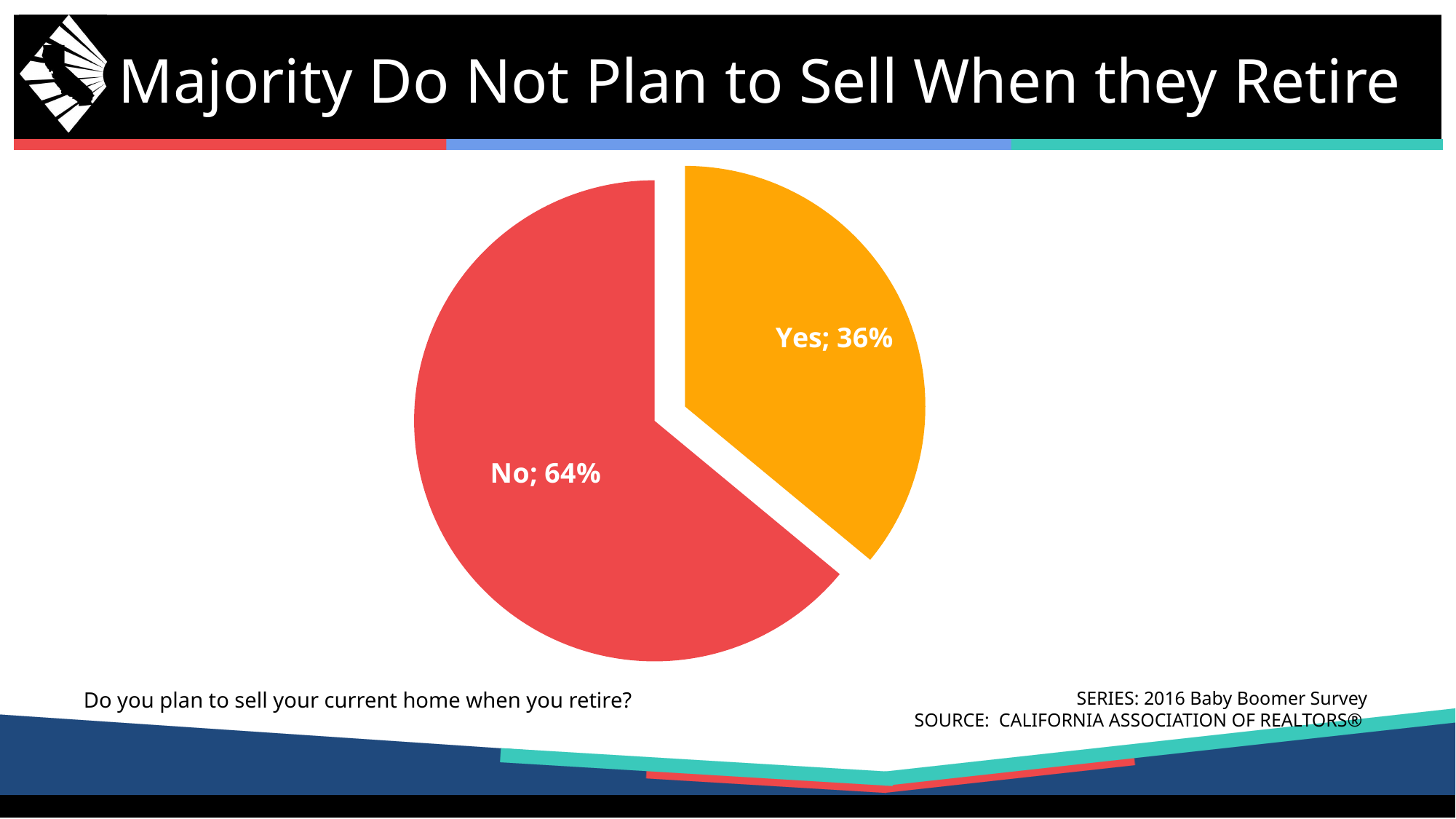
How many slices does the pie chart have? 2 What kind of chart is shown on the slide? Pie chart Which is larger, the "Yes" slice or the "No" slice? No What is the title of the slide? Majority Do Not Plan to Sell When they Retire Which response has the smallest share of the pie? Yes What colour is the "No" slice? Red What percentage of respondents answered "No"? 64% What share of the pie does the "Yes" slice represent? 36% Which response has the largest share of the pie? No What percentage of respondents answered "Yes"? 36% What is the difference in percentage points between the "No" and "Yes" slices? 28